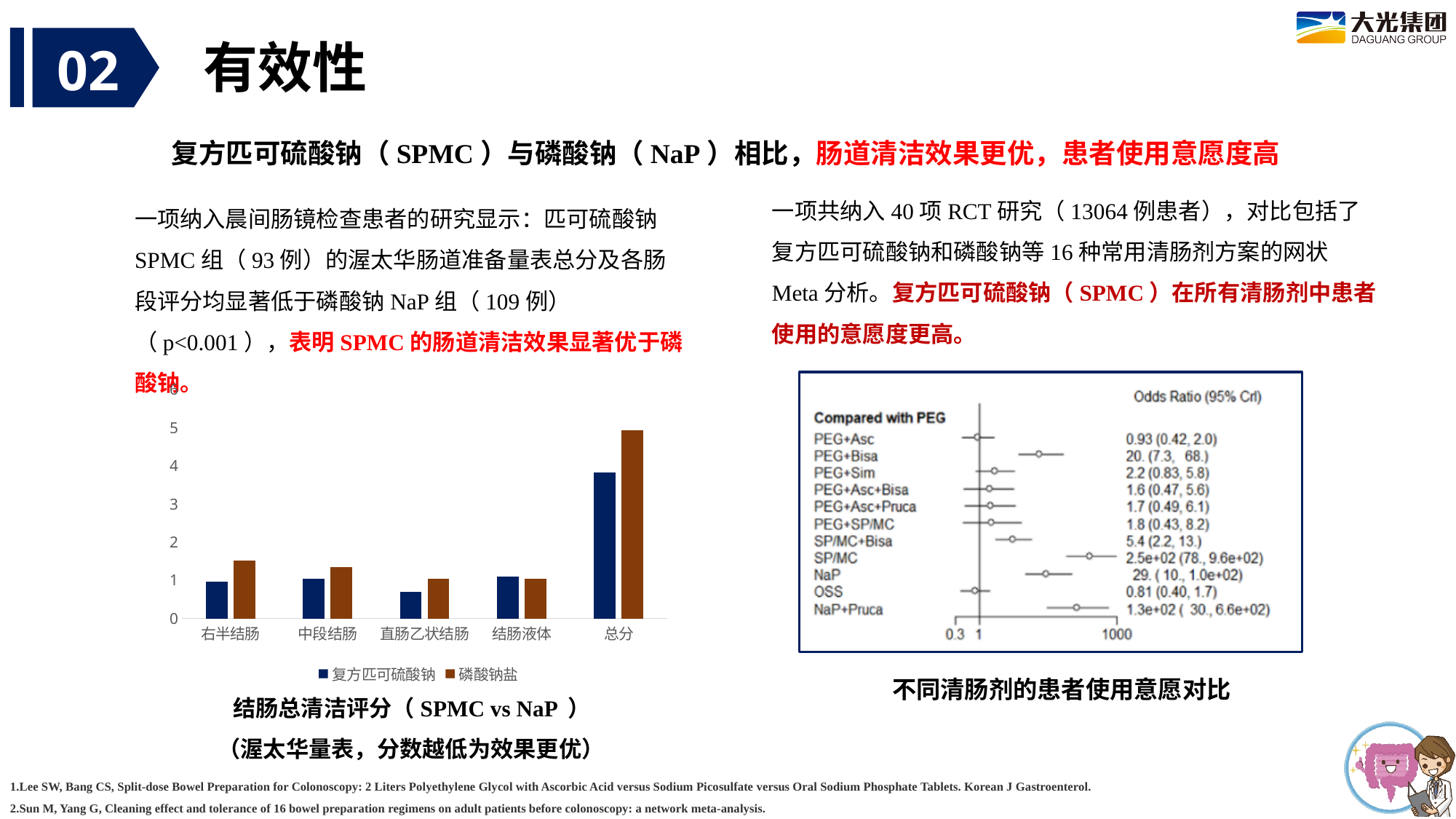
In the left bar chart, how many series does the legend list? 2 In the right forest plot (不同清肠剂的患者使用意愿对比), what is the odds ratio for SP/MC compared with PEG? 2.5e+02 (78., 9.6e+02) In the right forest plot, how many regimens are compared with PEG? 11 In the left bar chart, which category has the highest value for 磷酸钠盐? 总分 In the left bar chart, for 总分, which series has the larger value, 复方匹可硫酸钠 or 磷酸钠盐? 磷酸钠盐 In the left bar chart, is the 总分 value for 复方匹可硫酸钠 greater or less than 3? greater In the right forest plot, what is the odds ratio for NaP compared with PEG? 29. (10., 1.0e+02) What kind of chart is the left chart titled 结肠总清洁评分（SPMC vs NaP）? bar chart In the left bar chart, which category has the lowest value for 复方匹可硫酸钠? 直肠乙状结肠 In the left bar chart, how many categories are shown on the x axis? 5 In the right forest plot, which regimen has the lowest odds ratio compared with PEG? OSS